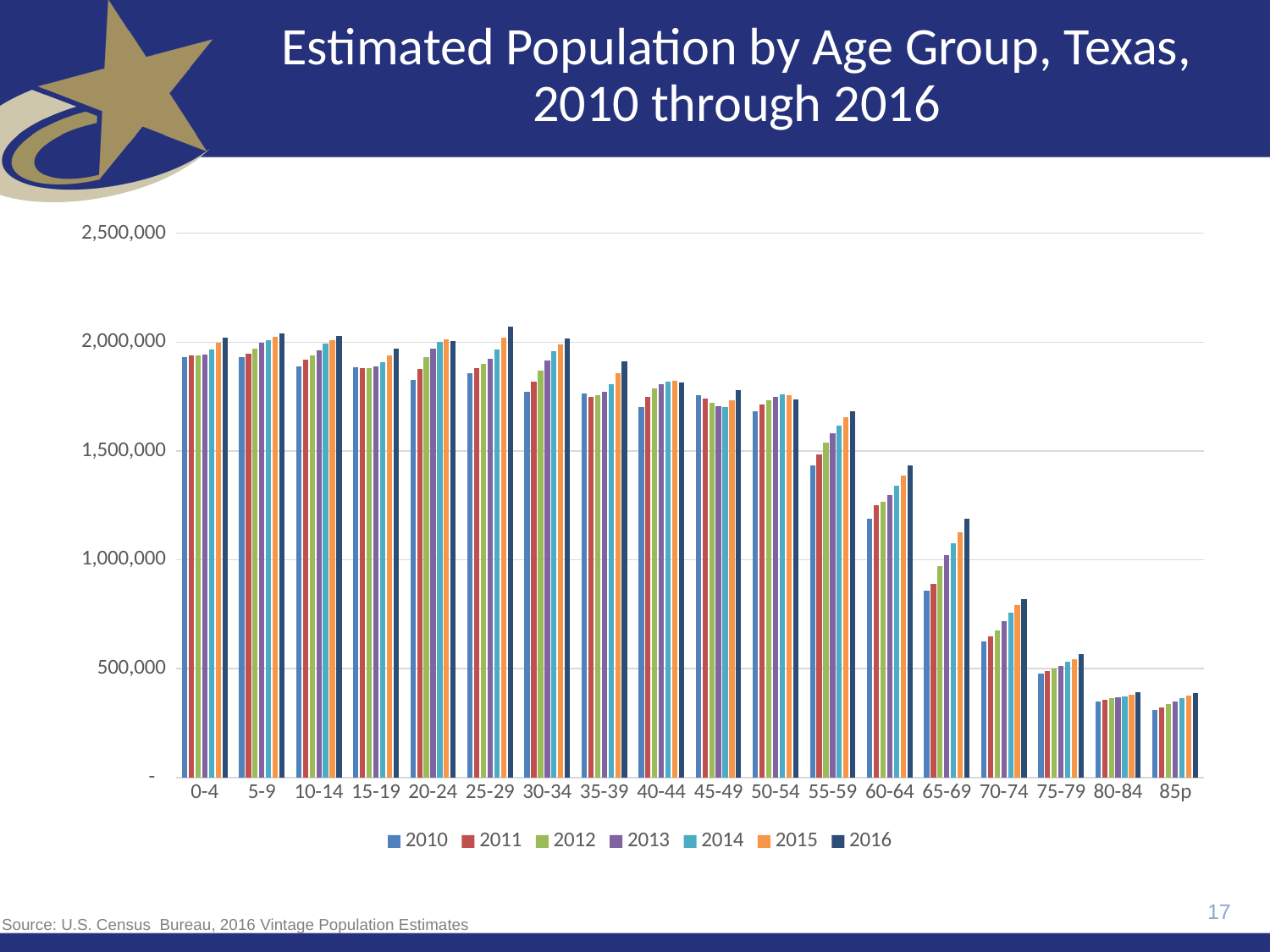
How many age groups are shown along the x axis? 18 Is the 2016 value for the 85p age group greater or less than 500,000? less Is the 2010 value for the 65-69 age group greater or less than 1,000,000? less Within the 65-69 age group, do the values rise or fall from 2010 to 2016? rise What is the title of the chart? Estimated Population by Age Group, Texas, 2010 through 2016 Moving from the 55-59 age group to the 85p age group, do the 2016 values rise or fall? fall What kind of chart is shown on the slide? bar chart Which is larger, the 2016 value for the 60-64 age group or the 2016 value for the 65-69 age group? 60-64 Is the 2010 value for the 60-64 age group greater or less than 1,000,000? greater How many series does the legend list? 7